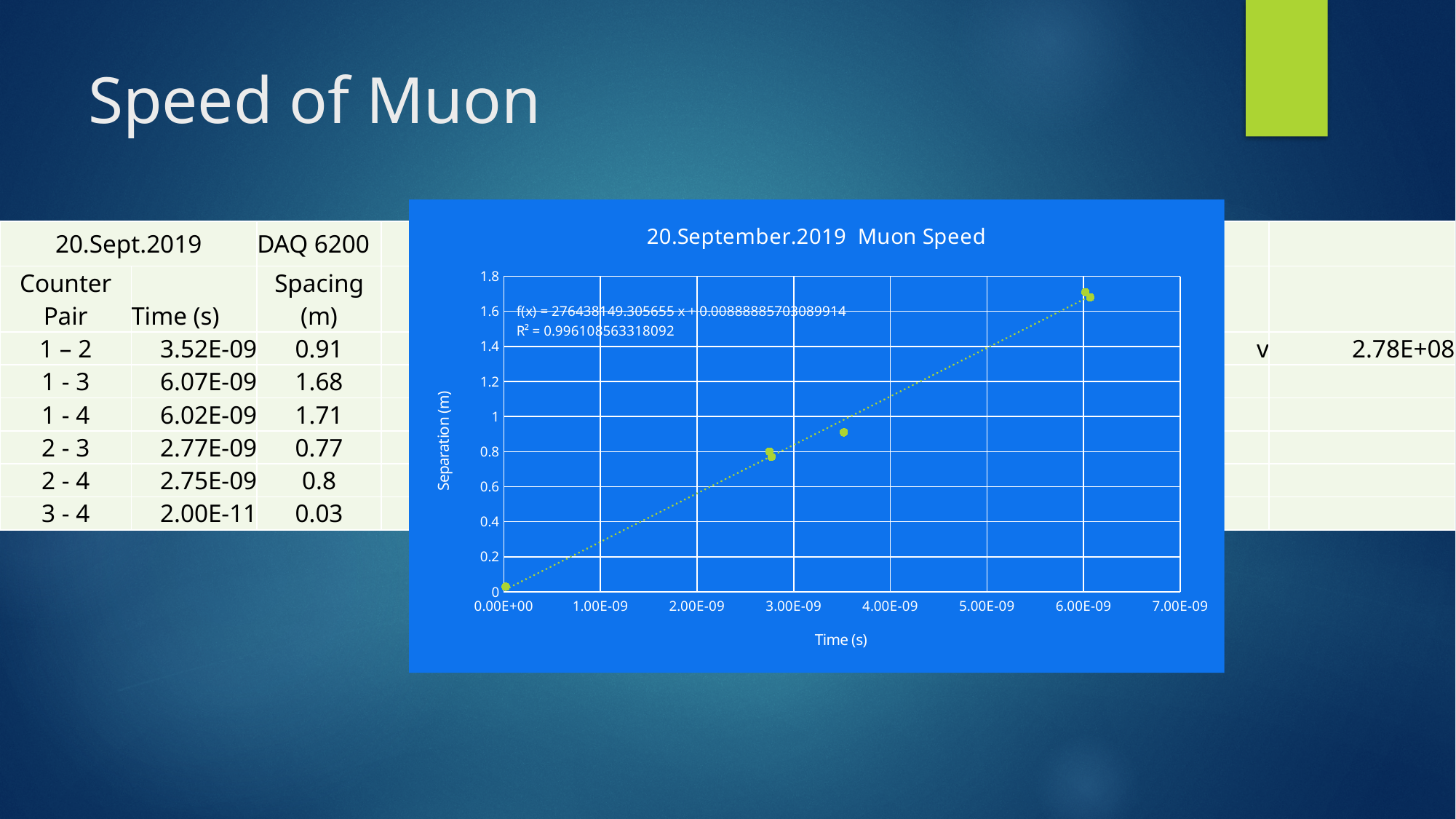
What is the highest tick value shown on the chart's vertical axis? 1.8 Is the separation value for the point at about 3.5E-09 s greater or less than 0.8? greater Are the separation values for the points near 6.00E-09 s greater or less than 1.6? greater What is the highest tick value shown on the chart's horizontal axis? 7.00E-09 What is the label of the chart's vertical axis? Separation (m) What kind of chart is shown on the slide? scatter chart How many data points are plotted in the chart? 6 What R² value is printed on the chart for the trendline? 0.996108563318092 Do the plotted separation values rise or fall as time increases along the x axis? rise Is the separation value for the point near 0.00E+00 s greater or less than 0.2? less What is the title of the chart? 20.September.2019 Muon Speed Which has the larger separation: the point near 6.00E-09 s or the point near 3.5E-09 s? the point near 6.00E-09 s